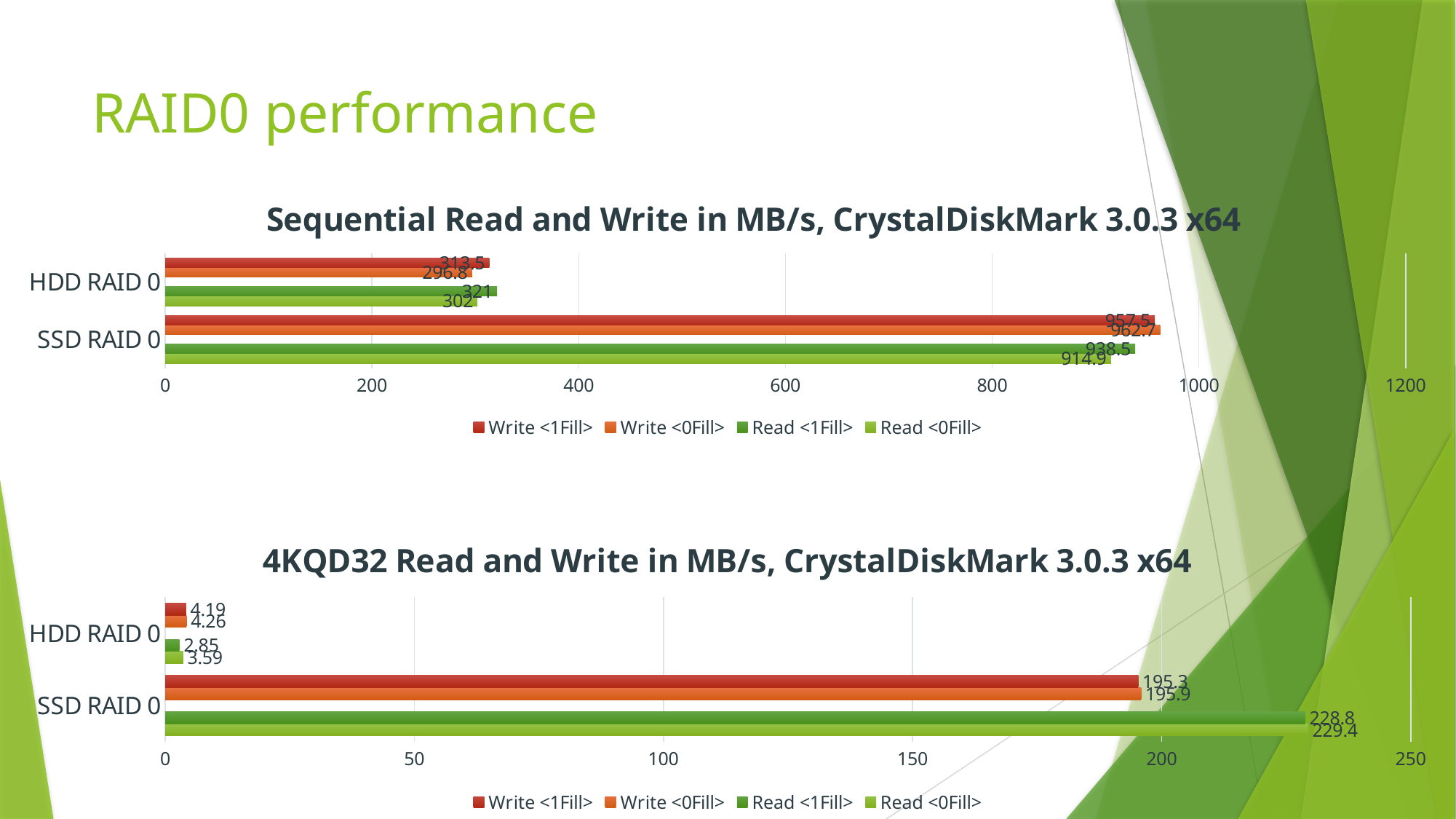
In the Sequential Read and Write chart, is the Read <0Fill> value for SSD RAID 0 greater or less than 800? greater In the 4KQD32 Read and Write chart, which series has the lowest value for HDD RAID 0? Read <1Fill> In the 4KQD32 Read and Write chart, which is larger for SSD RAID 0: Read <1Fill> or Write <1Fill>? Read <1Fill> What is the title of the top chart on the slide? Sequential Read and Write in MB/s, CrystalDiskMark 3.0.3 x64 In the Sequential Read and Write chart, what is the difference between the Write <1Fill> and Write <0Fill> values for HDD RAID 0? 16.7 In the 4KQD32 Read and Write chart, what is the Read <0Fill> value for SSD RAID 0? 229.4 In the Sequential Read and Write chart, what is the Write <0Fill> value for SSD RAID 0? 962.7 What kind of chart is the Sequential Read and Write chart? bar chart In the 4KQD32 Read and Write chart, what is the Write <1Fill> value for HDD RAID 0? 4.19 How many series does the legend of the 4KQD32 Read and Write chart list? 4 In the Sequential Read and Write chart, what is the Read <1Fill> value for HDD RAID 0? 321 How many categories are shown on the y axis of the 4KQD32 Read and Write chart? 2